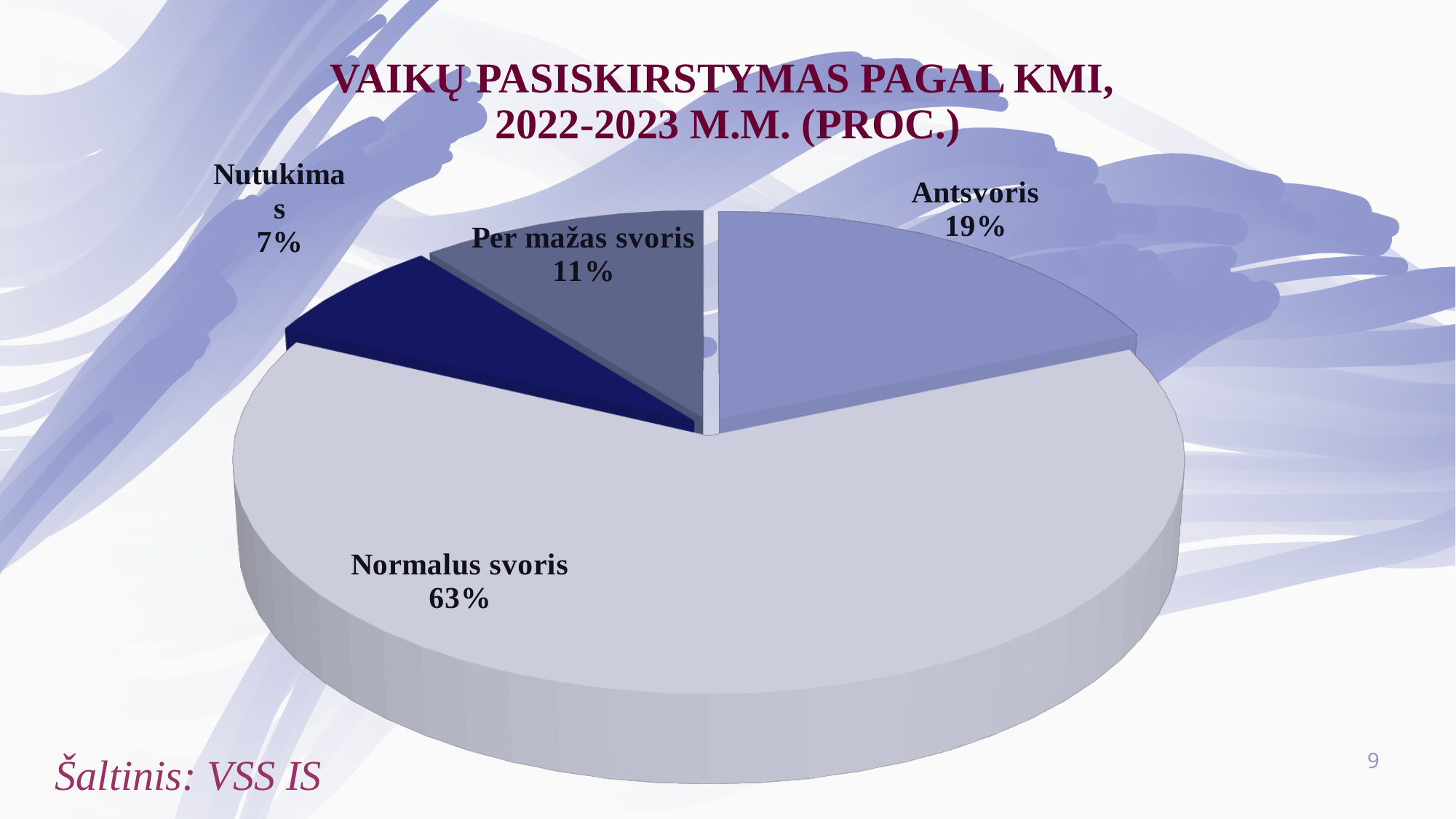
What percentage is shown for Antsvoris? 19% Which is larger, Per mažas svoris or Nutukimas? Per mažas svoris What is the difference in percentage points between Normalus svoris and Antsvoris? 44 What percentage is shown for Per mažas svoris? 11% What is the title of the chart? VAIKŲ PASISKIRSTYMAS PAGAL KMI, 2022-2023 M.M. (PROC.) What percentage of children fall into the Normalus svoris category? 63% What percentage is shown for Nutukimas? 7% Which category has the largest share of the pie? Normalus svoris Which category has the smallest share of the pie? Nutukimas How many categories are shown in the pie chart? 4 What is the difference in percentage points between Antsvoris and Nutukimas? 12 What type of chart is shown on the slide? Pie chart